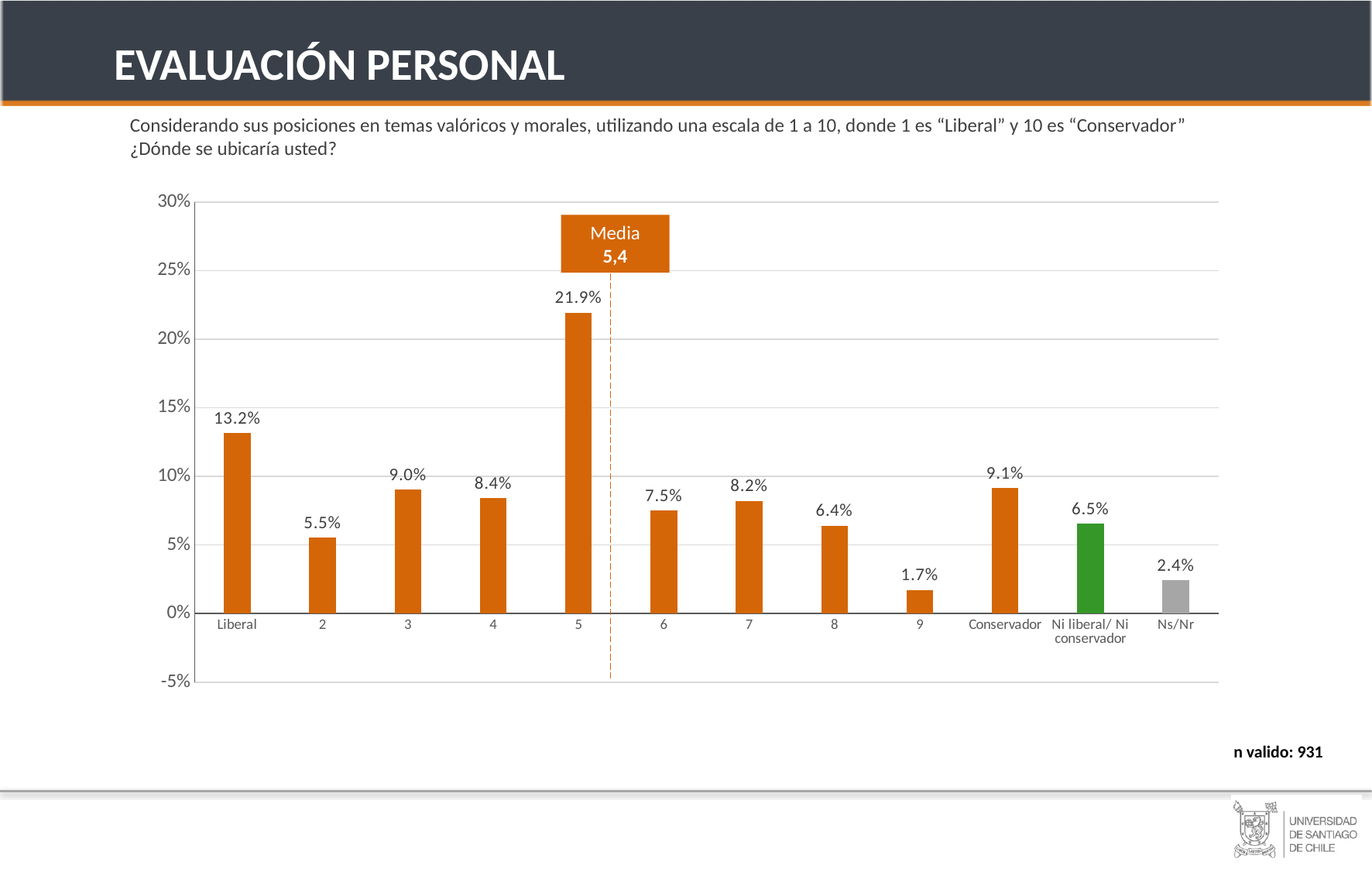
What is the value for category 5? 21.9% Which category has the highest value? 5 What is the value for Ns/Nr? 2.4% What mean (Media) value is shown in the label above the chart? 5,4 What is the value for the Liberal category? 13.2% How many categories are shown on the x axis? 12 Which is larger, the value for Conservador or the value for category 2? Conservador Which category has the lowest value? 9 What is the value for Ni liberal/ Ni conservador? 6.5% Is the value for category 3 greater or less than 5%? greater What is the difference between the values for category 5 and Liberal? 8.7% What kind of chart is shown on the slide? bar chart